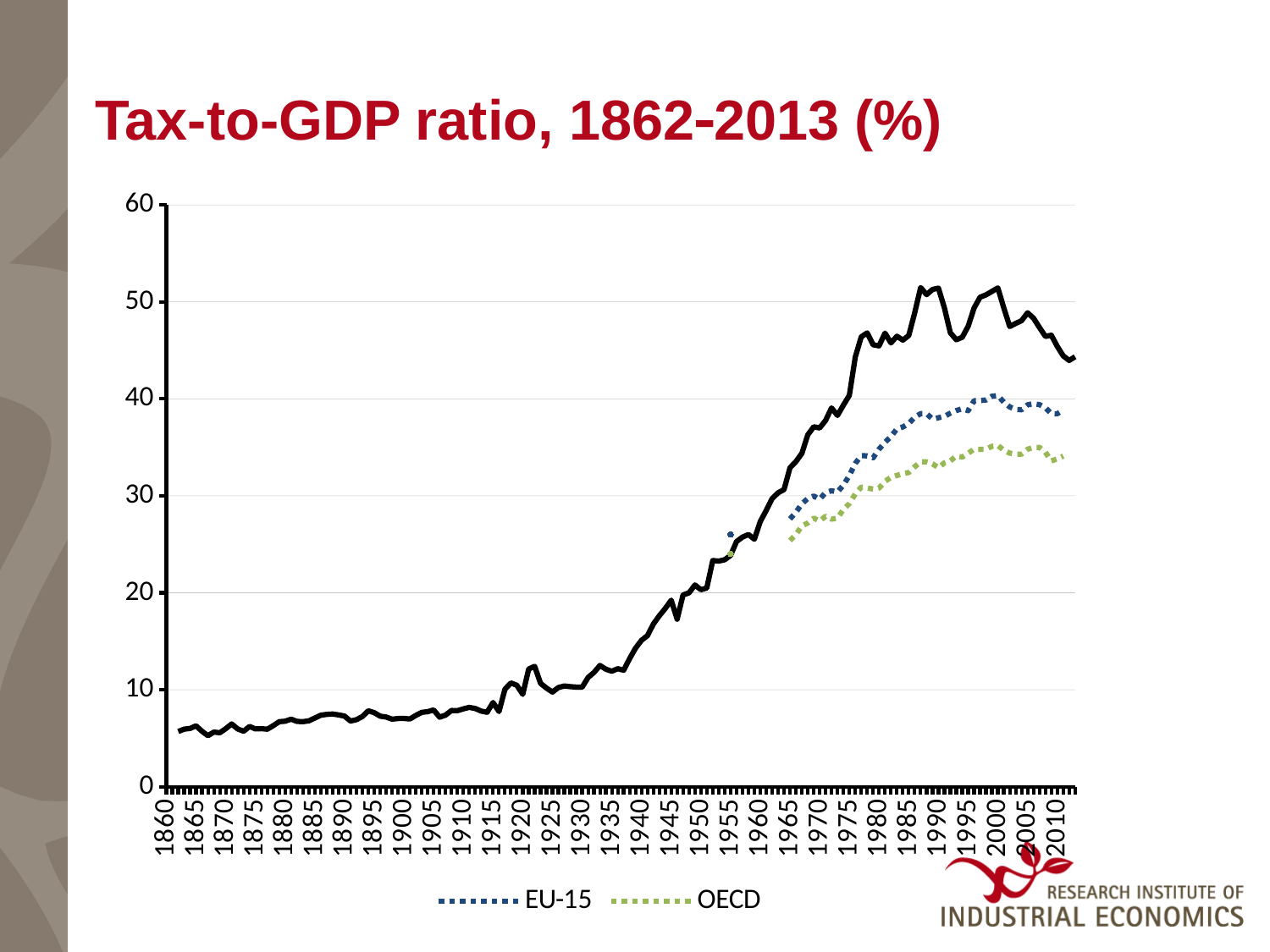
Is the value of the solid black line in 1940 greater or less than 20? less In 2000, which is higher, the EU-15 line or the OECD line? EU-15 Is the OECD value in 2010 greater or less than 40? less Does the solid black line generally rise or fall from 1860 to 2013? rise How many series does the legend list? 2 What kind of chart is shown on the slide? line chart What is the title of the chart? Tax-to-GDP ratio, 1862-2013 (%) Is the OECD value in 1965 greater or less than 30? less Which series is drawn as a green dotted line? OECD Which of the three lines is highest in 2010? the solid black line